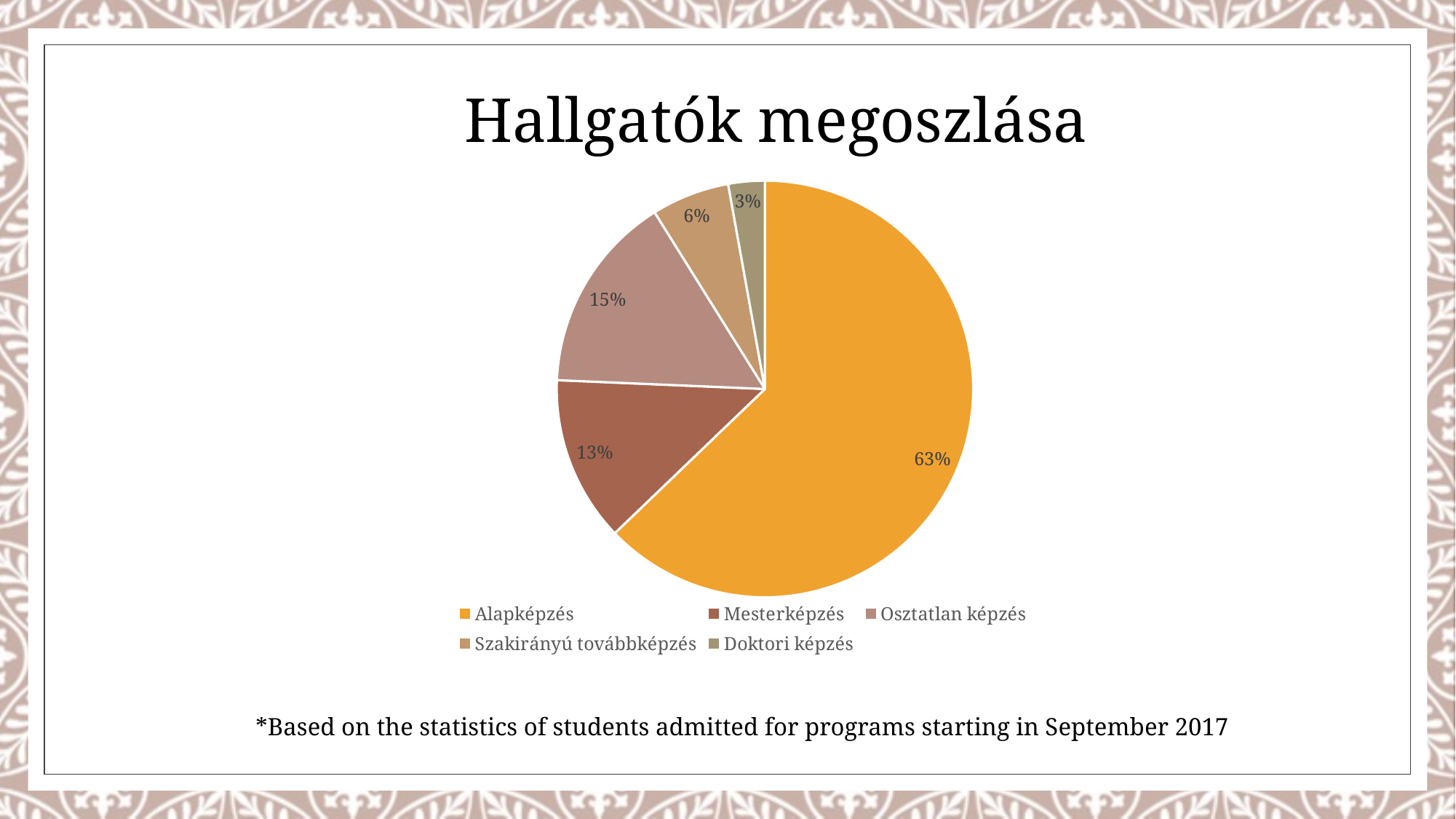
Which category has the smallest slice of the pie? Doktori képzés What is the title of the chart? Hallgatók megoszlása What share of the pie does Doktori képzés have? 3% Which is larger, the share for Osztatlan képzés or the share for Mesterképzés? Osztatlan képzés How many categories does the legend list? 5 What share of the pie does Mesterképzés have? 13% Which category has the largest slice of the pie? Alapképzés What is the difference in percentage points between the Alapképzés share and the Osztatlan képzés share? 48 What share of the pie does Alapképzés have? 63% What share of the pie does Osztatlan képzés have? 15% What share of the pie does Szakirányú továbbképzés have? 6% What kind of chart is shown on the slide? pie chart